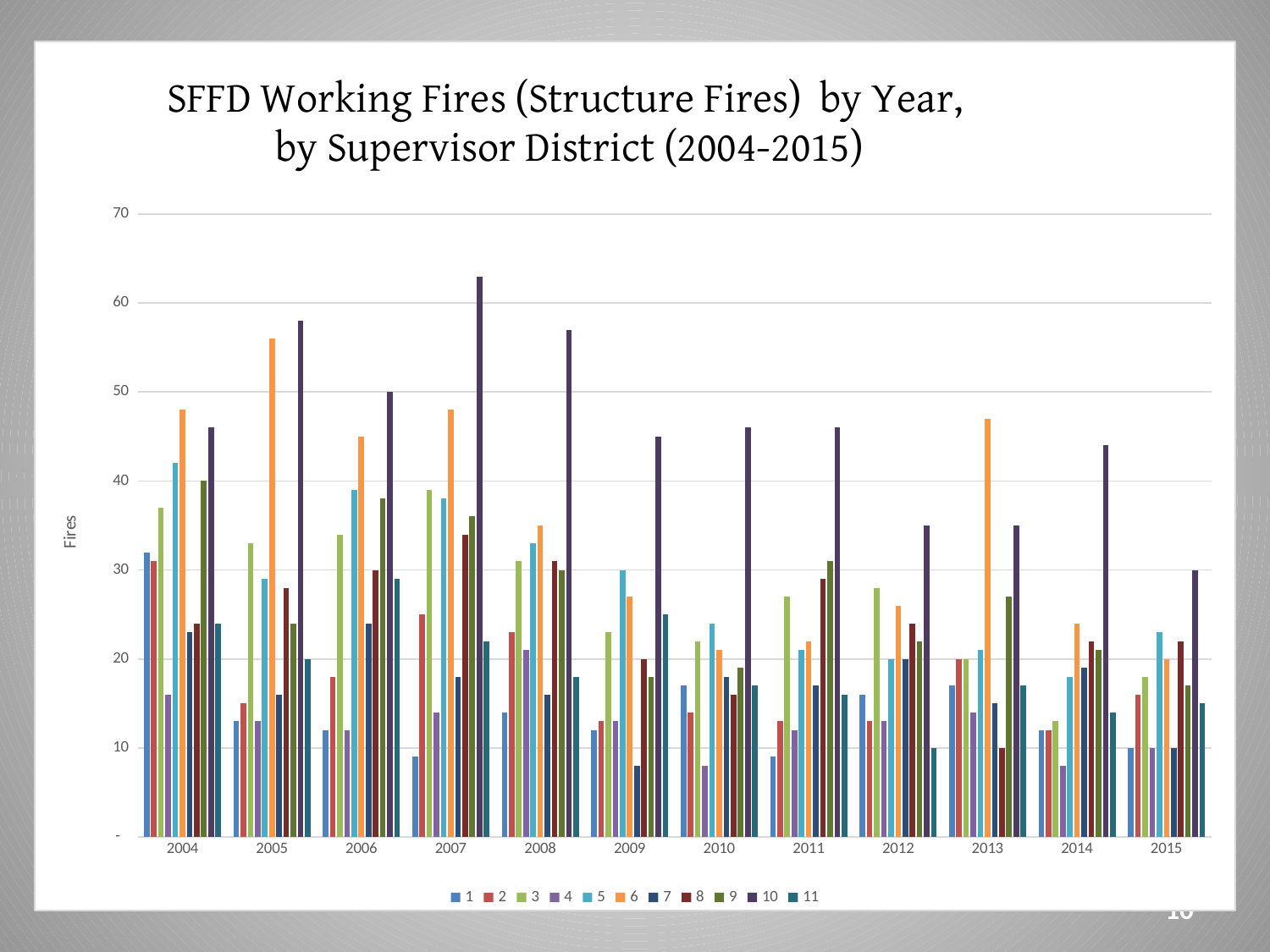
Which supervisor district has the lowest number of fires in 2009? 7 Which supervisor district has the lowest number of fires in 2010? 4 How many series does the legend list? 11 What kind of chart is shown on the slide? bar chart Which supervisor district has the highest number of fires in 2007? 10 Which is larger: the value for district 10 in 2007 or the value for district 10 in 2008? district 10 in 2007 Is the value for district 6 in 2005 greater or less than 50? greater How many years are shown along the x axis? 12 What is the label of the vertical axis? Fires Which supervisor district has the highest number of fires in 2013? 6 Is the value for district 7 in 2009 greater or less than 10? less Is the value for district 10 in 2007 greater or less than 60? greater